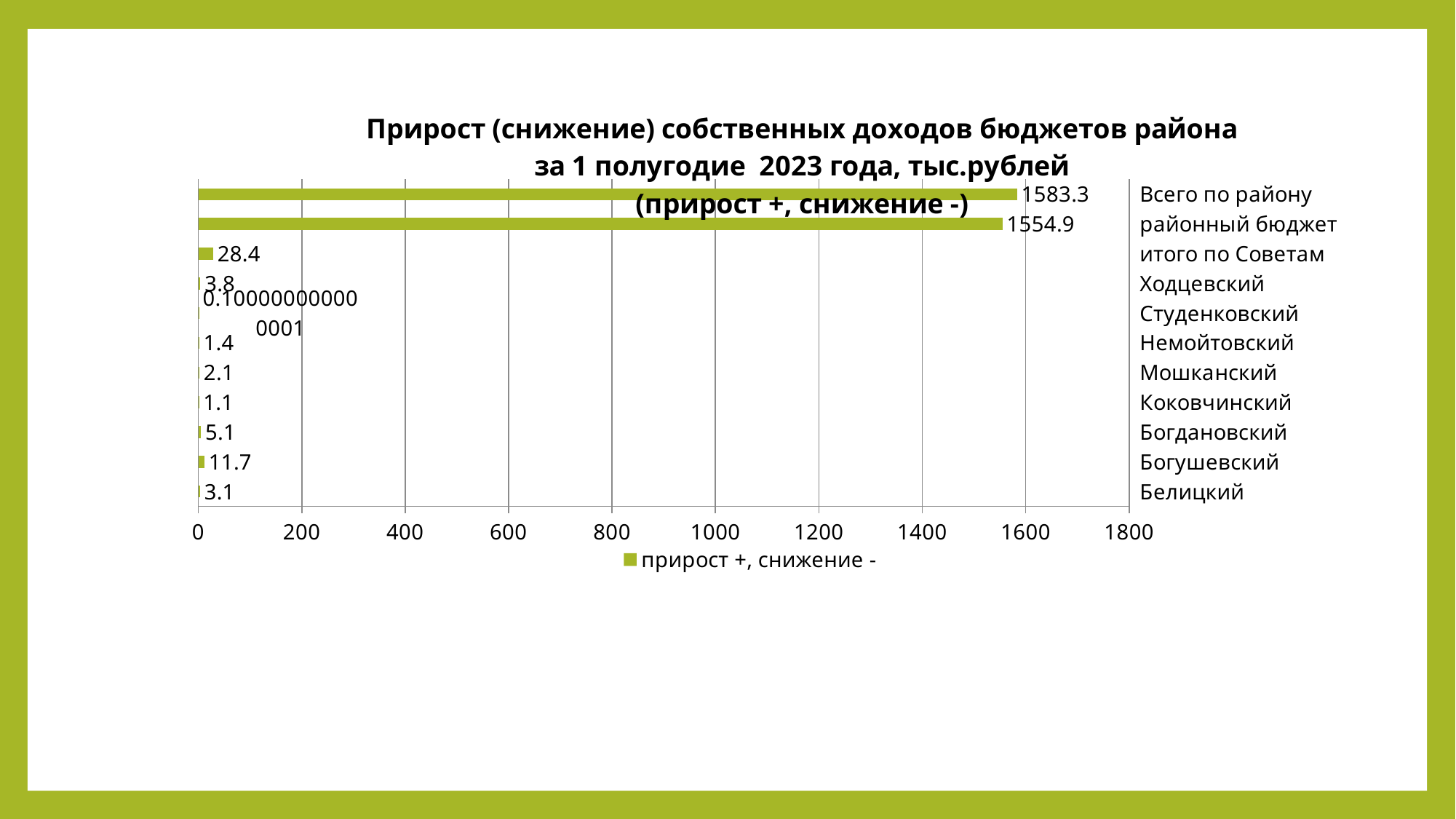
Is the value for районный бюджет greater or less than 1400? greater What is the value for итого по Советам? 28.4 What is the value for Всего по району? 1583.3 Which is larger, the value for Богушевский or the value for Ходцевский? Богушевский What is the value for районный бюджет? 1554.9 What type of chart is shown on the slide? bar chart Which category has the highest value? Всего по району What is the value for Богдановский? 5.1 How many series does the legend list? 1 How many categories are shown on the chart? 11 What is the difference between the values for Всего по району and районный бюджет? 28.4 What is the value for Богушевский? 11.7